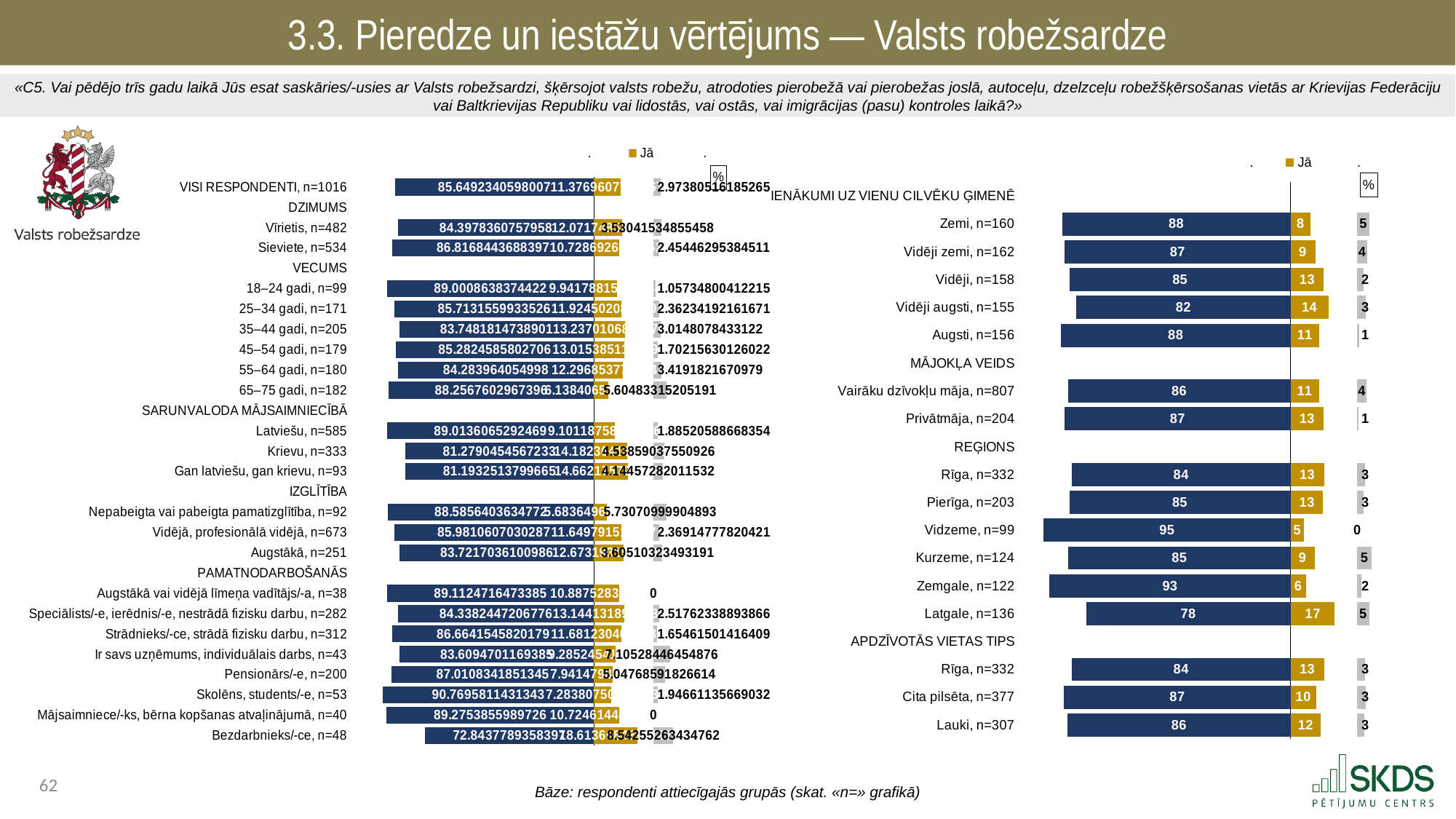
In the right-hand chart, which legend entry corresponds to the gold-coloured segments? Jā In the right-hand chart, how many categories are listed under REĢIONS? 6 In the right-hand chart, what is the "Jā" value for Latgale, n=136? 17 In the right-hand chart, what is the "Jā" value for Augsti, n=156? 11 What type of chart is shown on the right-hand side of the slide? Bar chart In the right-hand chart, which has the larger dark blue segment value: Zemgale, n=122 or Latgale, n=136? Zemgale, n=122 In the right-hand chart, what is the "Jā" value for Lauki, n=307? 12 In the right-hand chart, which region under REĢIONS has the lowest "Jā" value? Vidzeme, n=99 In the right-hand chart, what is the difference between the "Jā" values for Latgale, n=136 and Vidzeme, n=99? 12 In the right-hand chart, what is the value of the dark blue segment for Vidzeme, n=99? 95 In the right-hand chart, how many categories are listed under IENĀKUMI UZ VIENU CILVĒKU ĢIMENĒ? 5 In the right-hand chart, which region under REĢIONS has the highest "Jā" value? Latgale, n=136